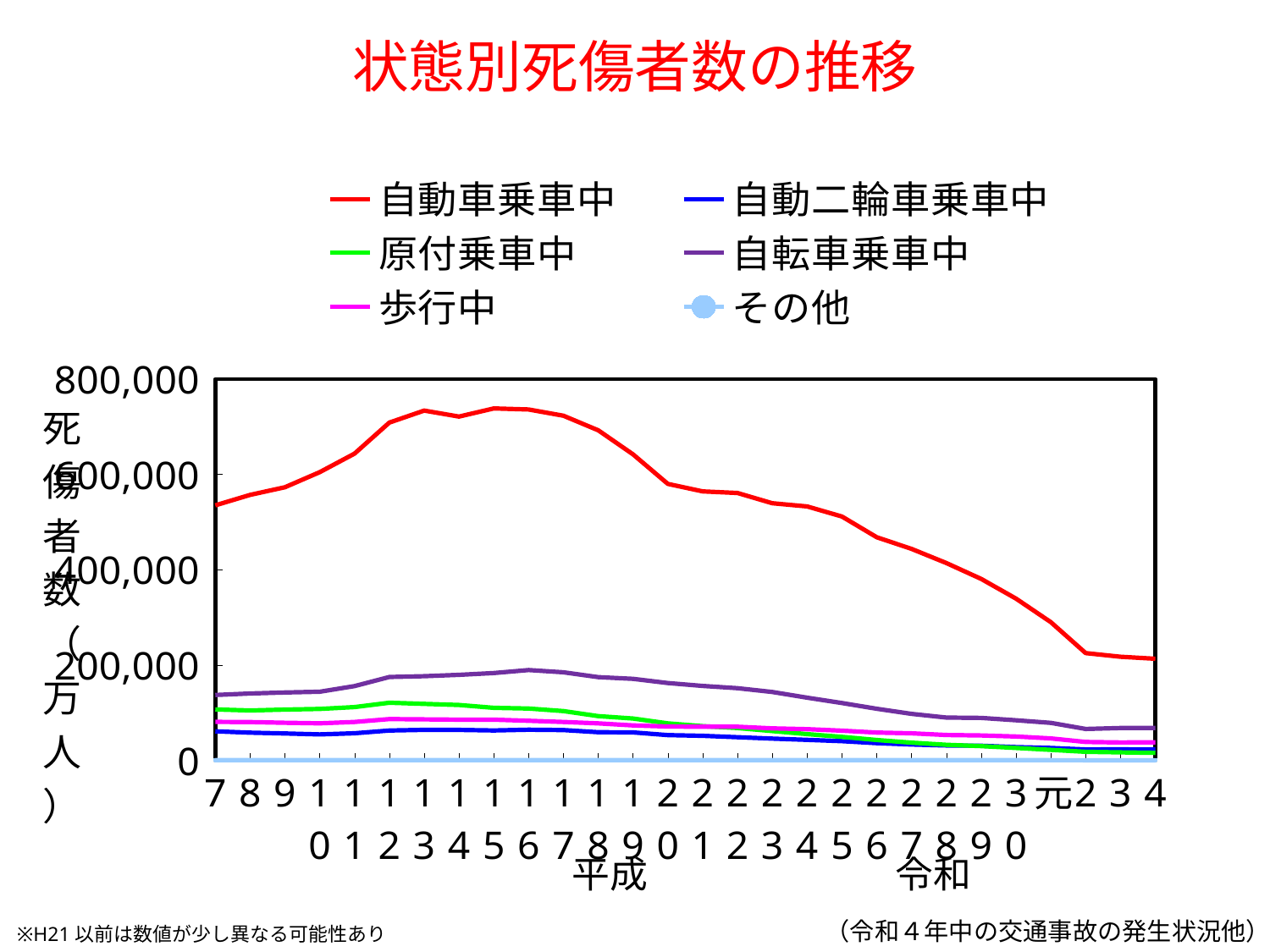
Is the peak value for 自動車乗車中 greater or less than 800,000? less Is the value for 自動車乗車中 in 令和4 greater or less than 400,000? less Which is larger in 平成16, 自転車乗車中 or 歩行中? 自転車乗車中 Which series is drawn in red? 自動車乗車中 Does the 自動車乗車中 line rise or fall from 平成16 to 令和4? fall What is the title of the chart? 状態別死傷者数の推移 What kind of chart is shown on the slide? line chart Which series has the lowest values across the whole period? その他 Which series has the highest values across the whole period? 自動車乗車中 Is the value for 自動車乗車中 in 平成7 greater or less than 400,000? greater How many series does the legend list? 6